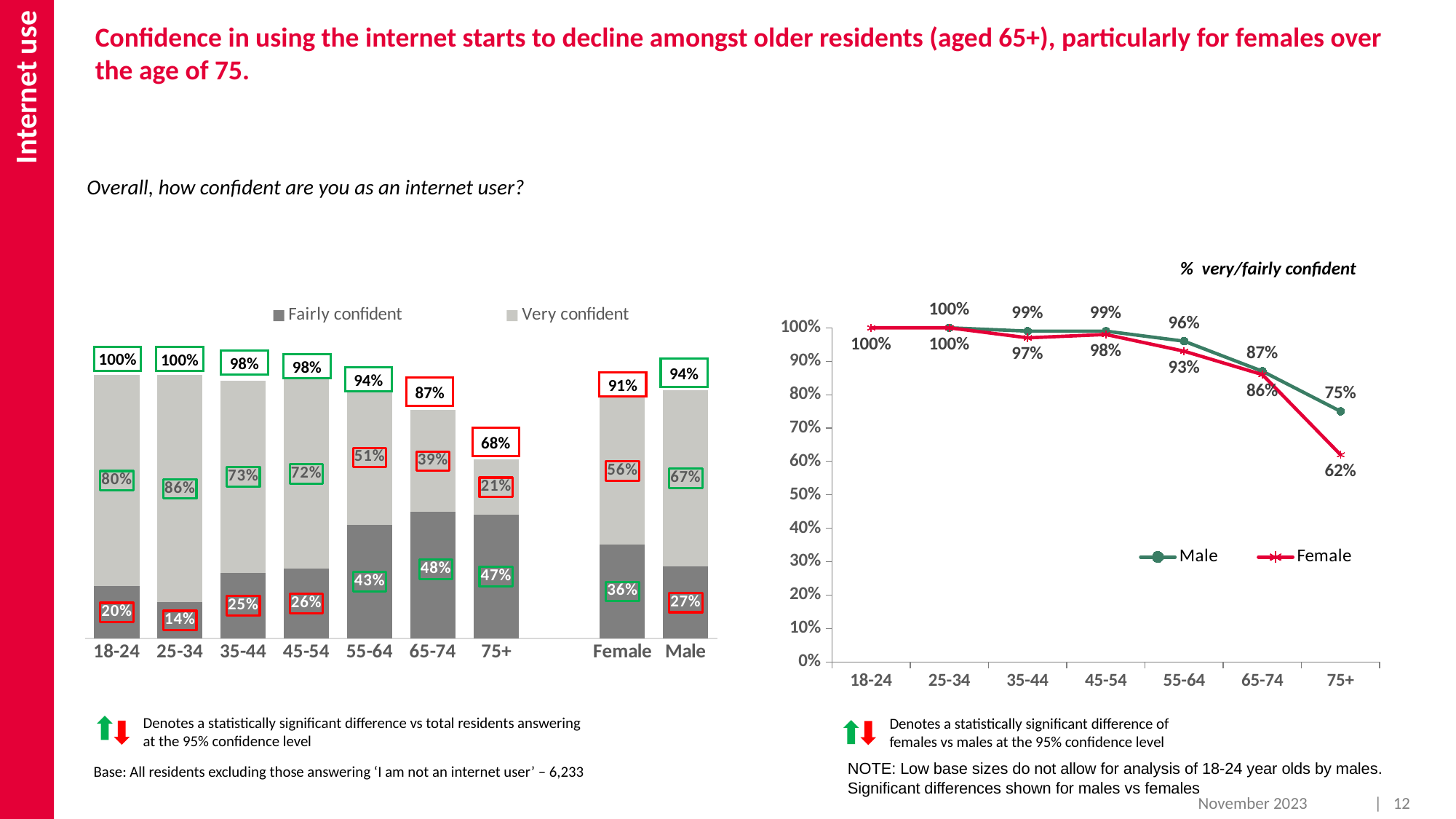
In the line chart on the right, what is the difference between the Male and Female values for the 75+ age group? 13% In the line chart on the right, what is the Male value for the 55-64 age group? 96% In the line chart on the right, do the values generally rise or fall as age increases from 45-54 to 75+? fall In the stacked bar chart on the left, what percentage of 25-34 year olds are 'Very confident'? 86% In the stacked bar chart on the left, what is the difference between the 'Very confident' percentages for Male and Female? 11% How many series does the legend of the stacked bar chart on the left list? 2 In the line chart on the right, what is the Female value for the 75+ age group? 62% What type of chart is shown on the right side of the slide? line chart In the stacked bar chart on the left, which age group has the lowest 'Very confident' percentage? 75+ In the stacked bar chart on the left, what is the total (very/fairly confident) for the 75+ age group? 68% In the stacked bar chart on the left, what percentage of 65-74 year olds are 'Fairly confident'? 48% In the stacked bar chart on the left, which is larger: the 'Fairly confident' share for 55-64 or for 45-54? 55-64